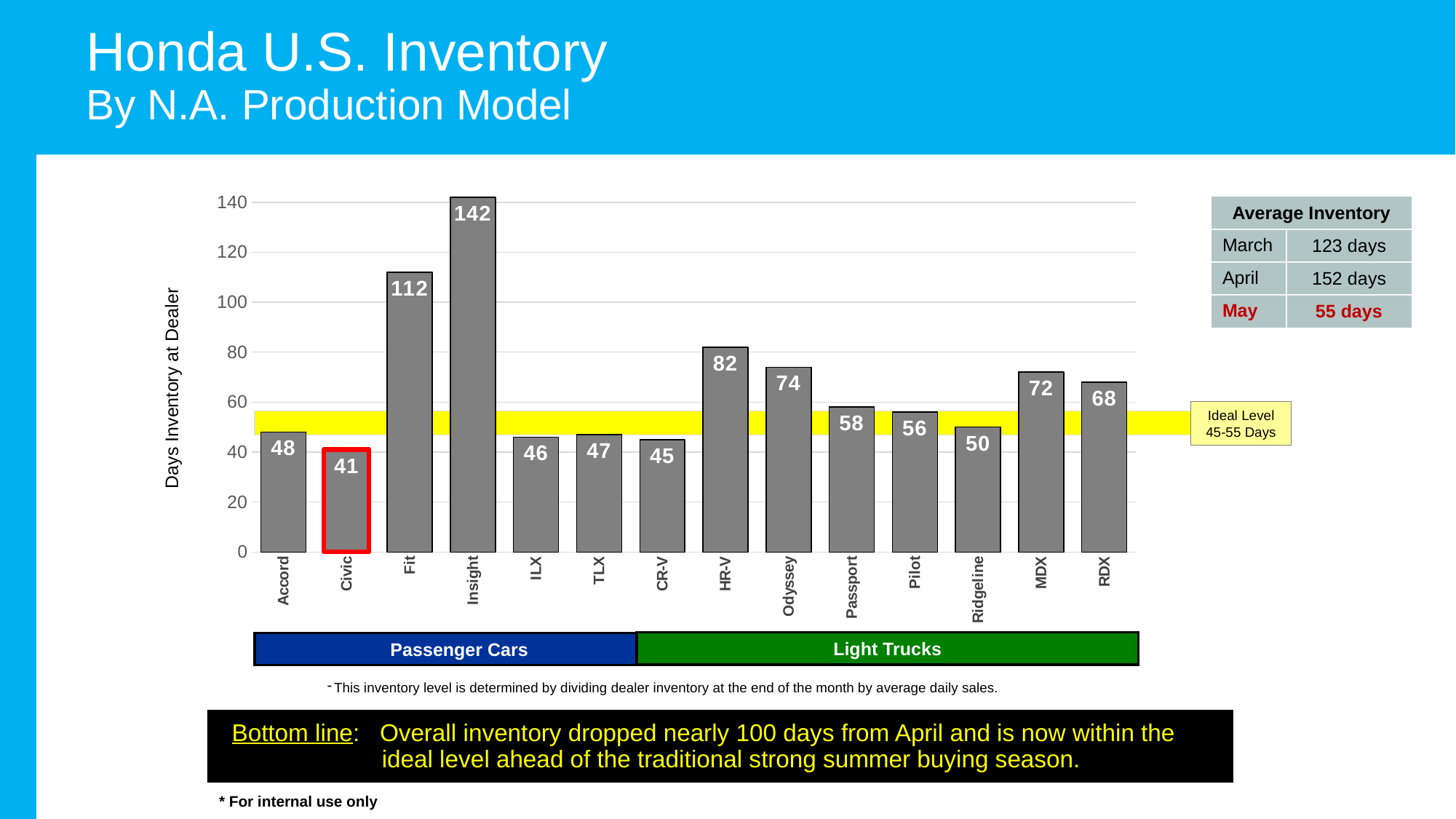
Which model has the lowest days inventory at dealer? Civic What is the days inventory at dealer for Civic? 41 Which model has the highest days inventory at dealer? Insight What is the days inventory at dealer for HR-V? 82 How many models are shown on the x axis of the chart? 14 What kind of chart is shown on the slide? Bar chart What is the days inventory at dealer for Insight? 142 Is the value for Fit greater or less than 100? greater What is the label on the vertical axis of the chart? Days Inventory at Dealer What is the difference in days inventory between Insight and Fit? 30 What is the difference in days inventory between MDX and RDX? 4 Which has a higher days inventory, Odyssey or Passport? Odyssey